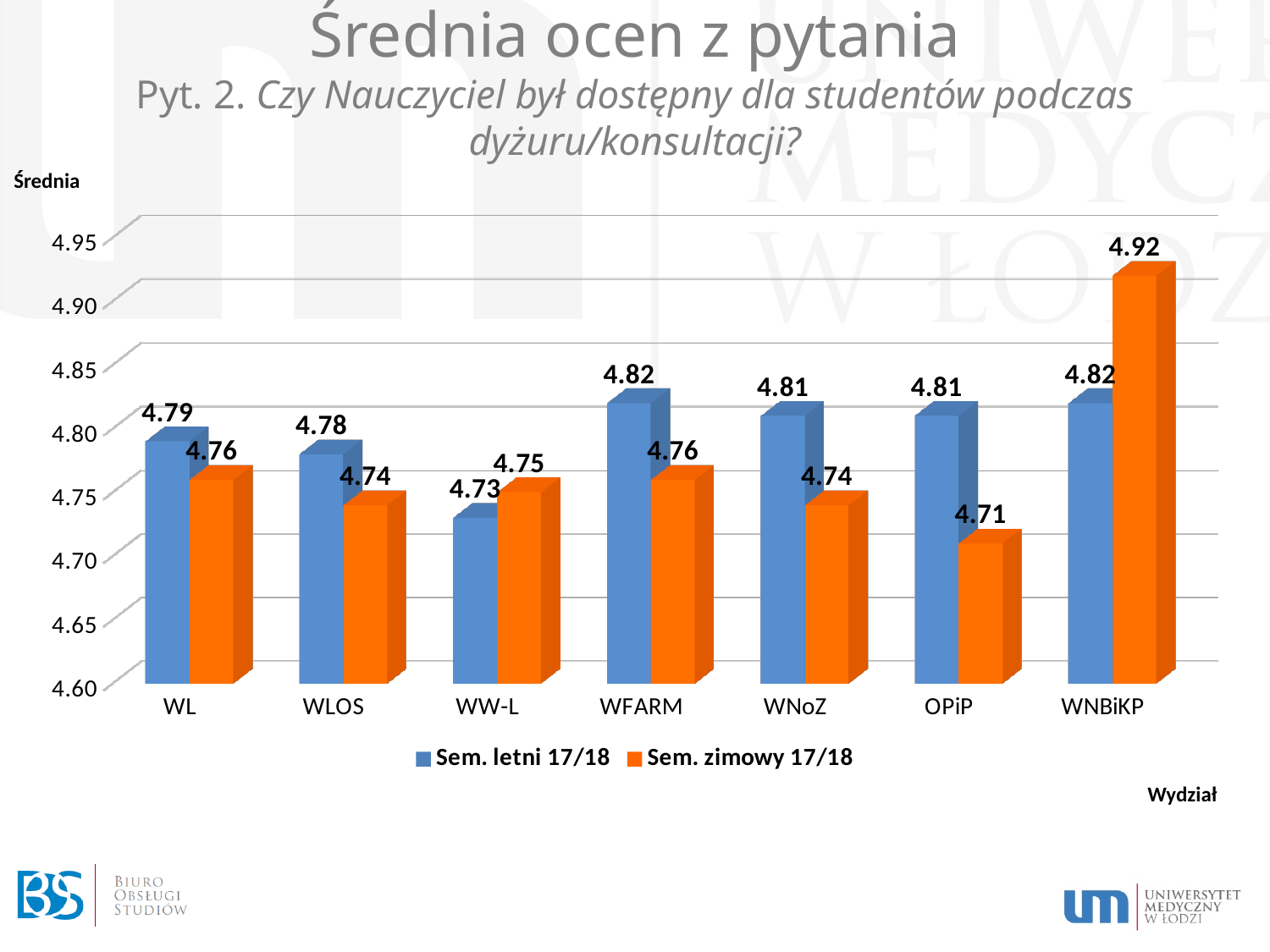
What is the value for WNBiKP in the Sem. zimowy 17/18 series? 4.92 Which category has the lowest value in the Sem. letni 17/18 series? WW-L What kind of chart is shown on the slide? bar chart What is the value for WL in the Sem. letni 17/18 series? 4.79 Which category has the highest value in the Sem. zimowy 17/18 series? WNBiKP How many categories are shown on the x axis? 7 Which is larger for WNBiKP: the Sem. letni 17/18 value or the Sem. zimowy 17/18 value? Sem. zimowy 17/18 Is the Sem. zimowy 17/18 value for WNBiKP greater or less than 4.90? greater How many series does the legend list? 2 What is the label of the y axis? Średnia What is the value for OPiP in the Sem. zimowy 17/18 series? 4.71 What is the difference between the Sem. letni 17/18 and Sem. zimowy 17/18 values for OPiP? 0.10